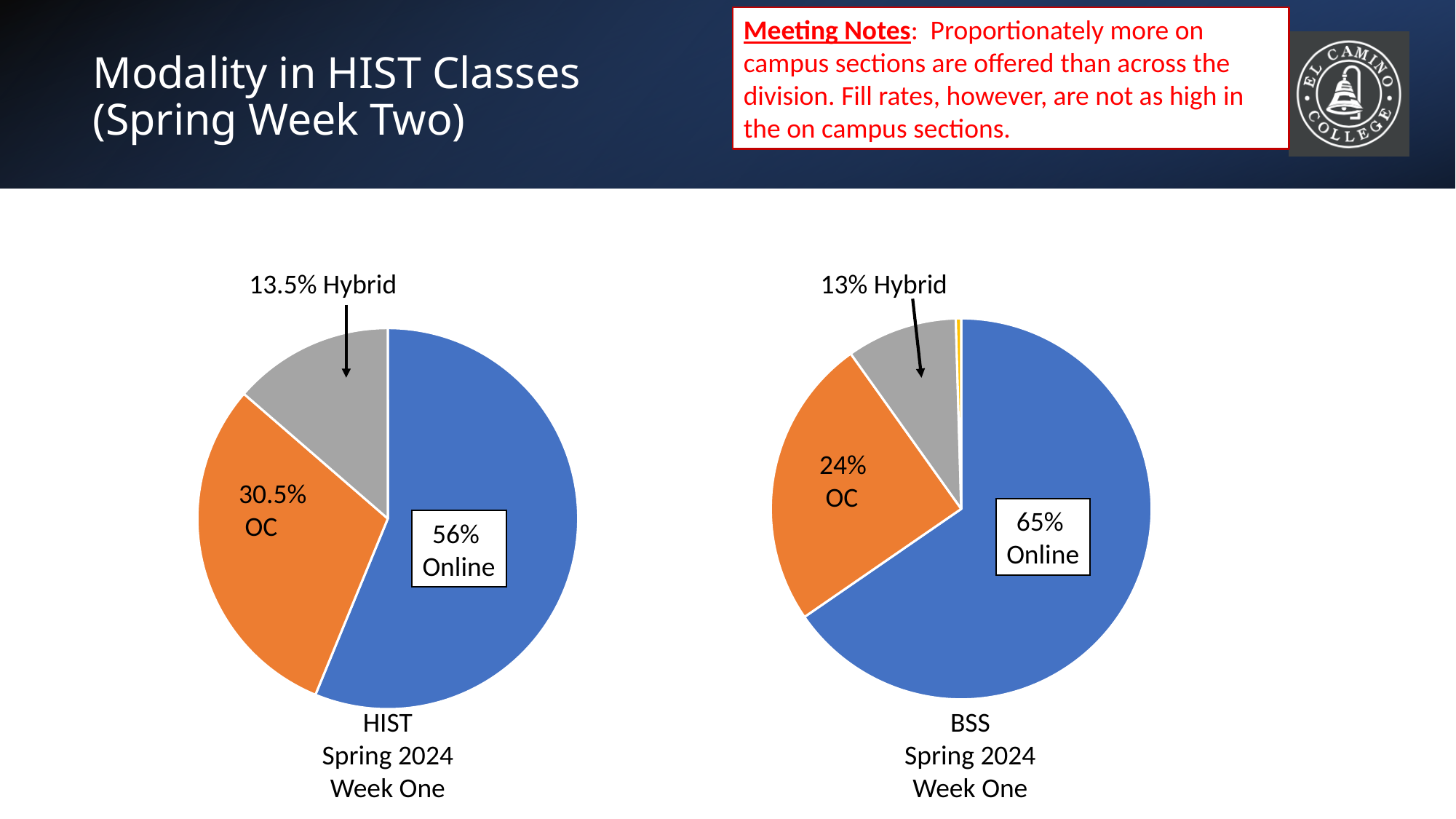
How many labelled slices does the HIST Spring 2024 Week One pie chart have? 3 In the HIST Spring 2024 Week One pie chart, what share of sections is Online? 56% In the BSS Spring 2024 Week One pie chart, which labelled modality has the smallest slice? Hybrid What kind of chart is used for HIST Spring 2024 Week One? Pie chart In the HIST Spring 2024 Week One pie chart, what share of sections is Hybrid? 13.5% In the BSS Spring 2024 Week One pie chart, what share of sections is OC? 24% In the HIST Spring 2024 Week One pie chart, which modality has the largest slice? Online In the BSS Spring 2024 Week One pie chart, what share of sections is Online? 65% Which chart shows a larger Online share, HIST Spring 2024 Week One or BSS Spring 2024 Week One? BSS Spring 2024 Week One In the BSS Spring 2024 Week One pie chart, what share of sections is Hybrid? 13% In the HIST Spring 2024 Week One pie chart, what share of sections is OC? 30.5% What is the difference between the OC share in the HIST chart and the OC share in the BSS chart? 6.5%